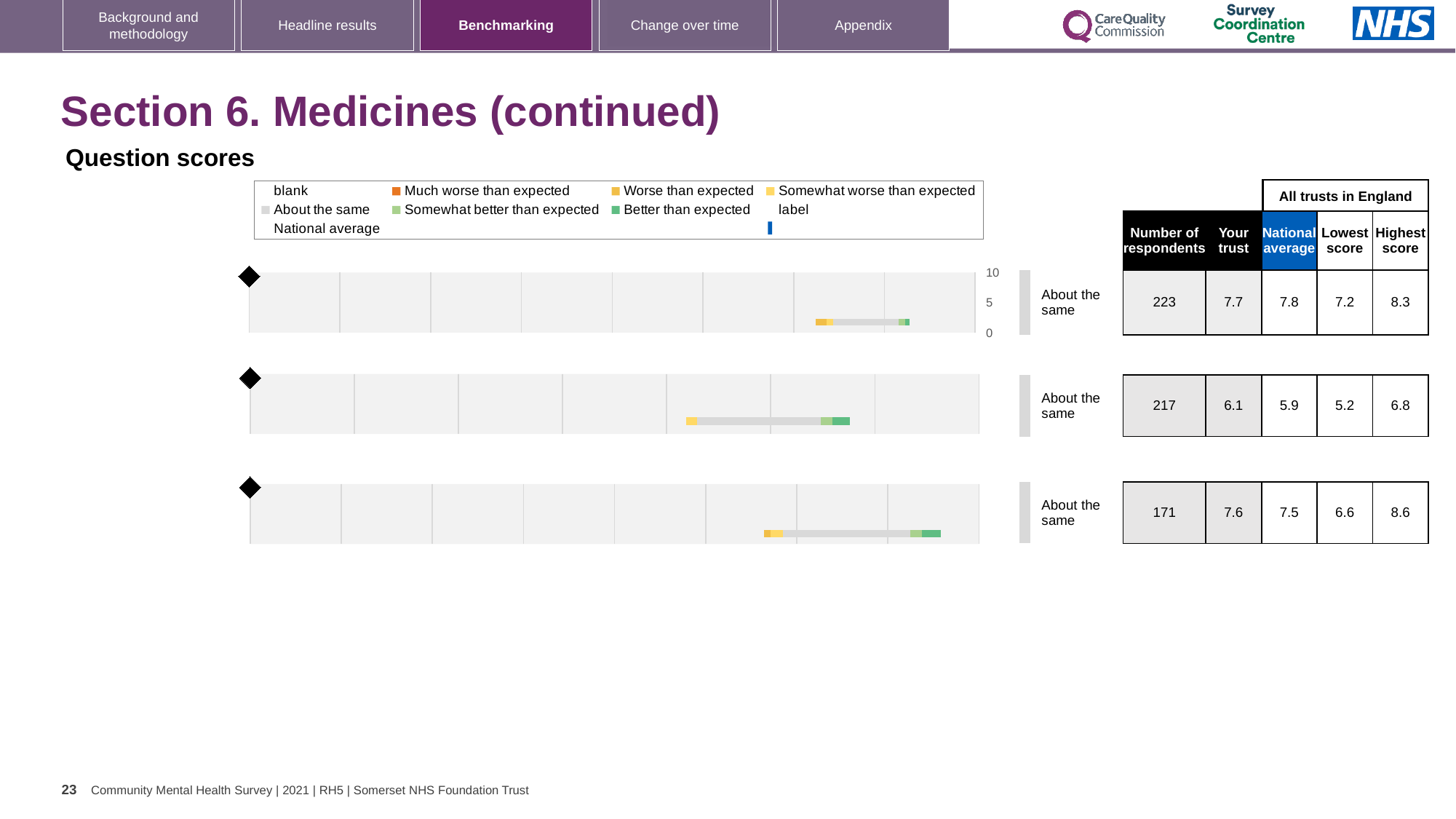
For the first (top) chart, what is the national average score? 7.8 How many benchmark charts are shown on the slide? 3 For the first (top) chart, what is the 'Your trust' score? 7.7 What is the maximum value shown on the chart axis? 10 What kind of chart is used for the benchmarking rows on this slide? bar chart For the second (middle) chart, how many respondents are there? 217 For the second (middle) chart, what is the difference between the highest score and the lowest score? 1.6 For the first (top) chart, which is larger: the 'Your trust' score or the national average? National average For the third (bottom) chart, what is the highest score among all trusts in England? 8.6 What benchmark category label is shown beside each of the three charts? About the same For the second (middle) chart, is the 'Your trust' score greater or less than 5? greater Which of the three charts has the lowest 'Your trust' score? the second (middle) chart